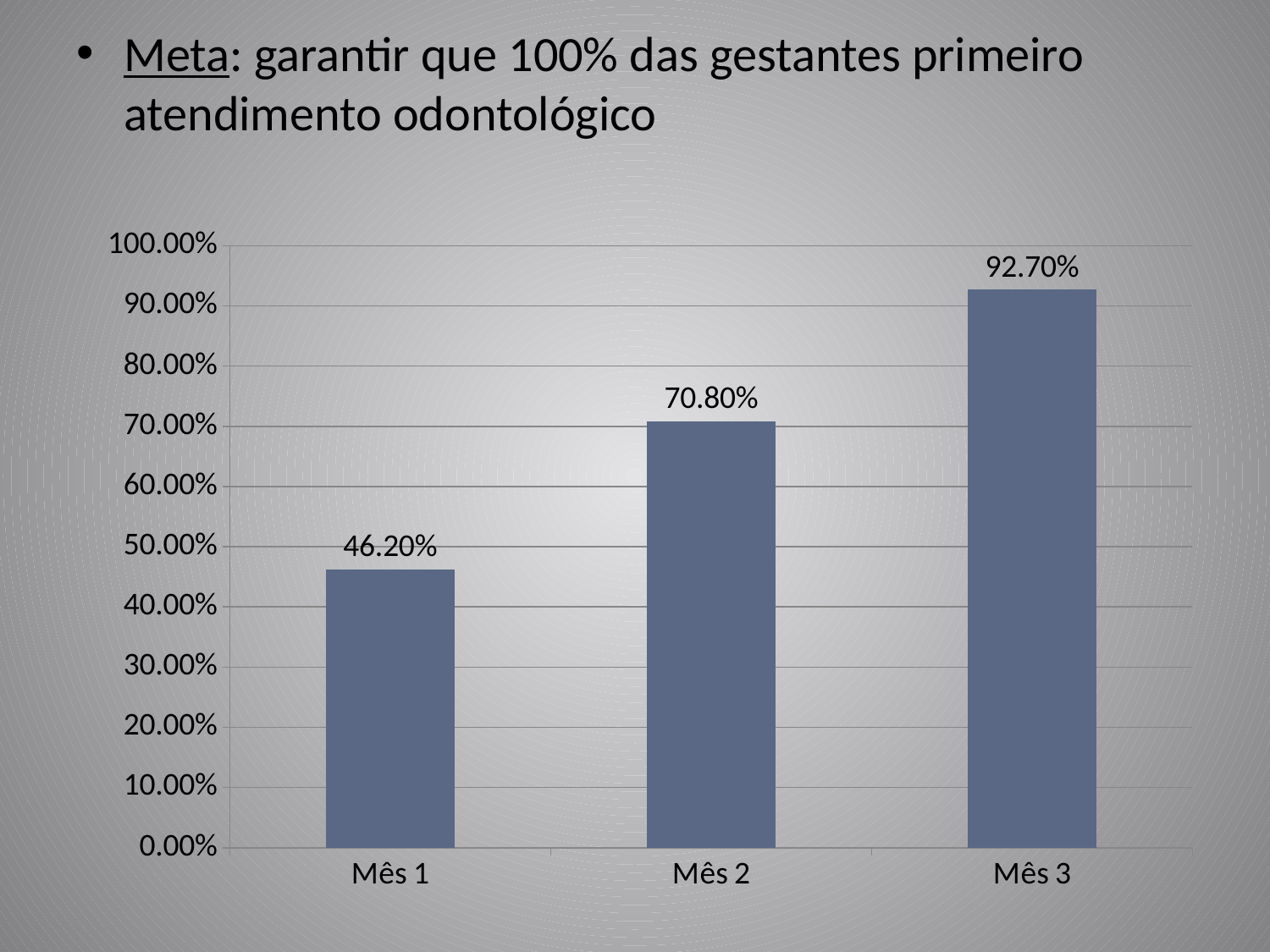
Which is larger, the value for Mês 2 or the value for Mês 3? Mês 3 Which month has the highest value? Mês 3 What kind of chart is shown on the slide? bar chart What is the difference between the values for Mês 2 and Mês 1? 24.60% Which month has the lowest value? Mês 1 What is the value for Mês 2? 70.80% What is the value for Mês 3? 92.70% What is the value for Mês 1? 46.20% What is the difference between the values for Mês 3 and Mês 1? 46.50% Is the value for Mês 1 greater or less than 50.00%? less Do the values rise or fall from Mês 1 to Mês 3? rise How many months are shown on the x axis? 3